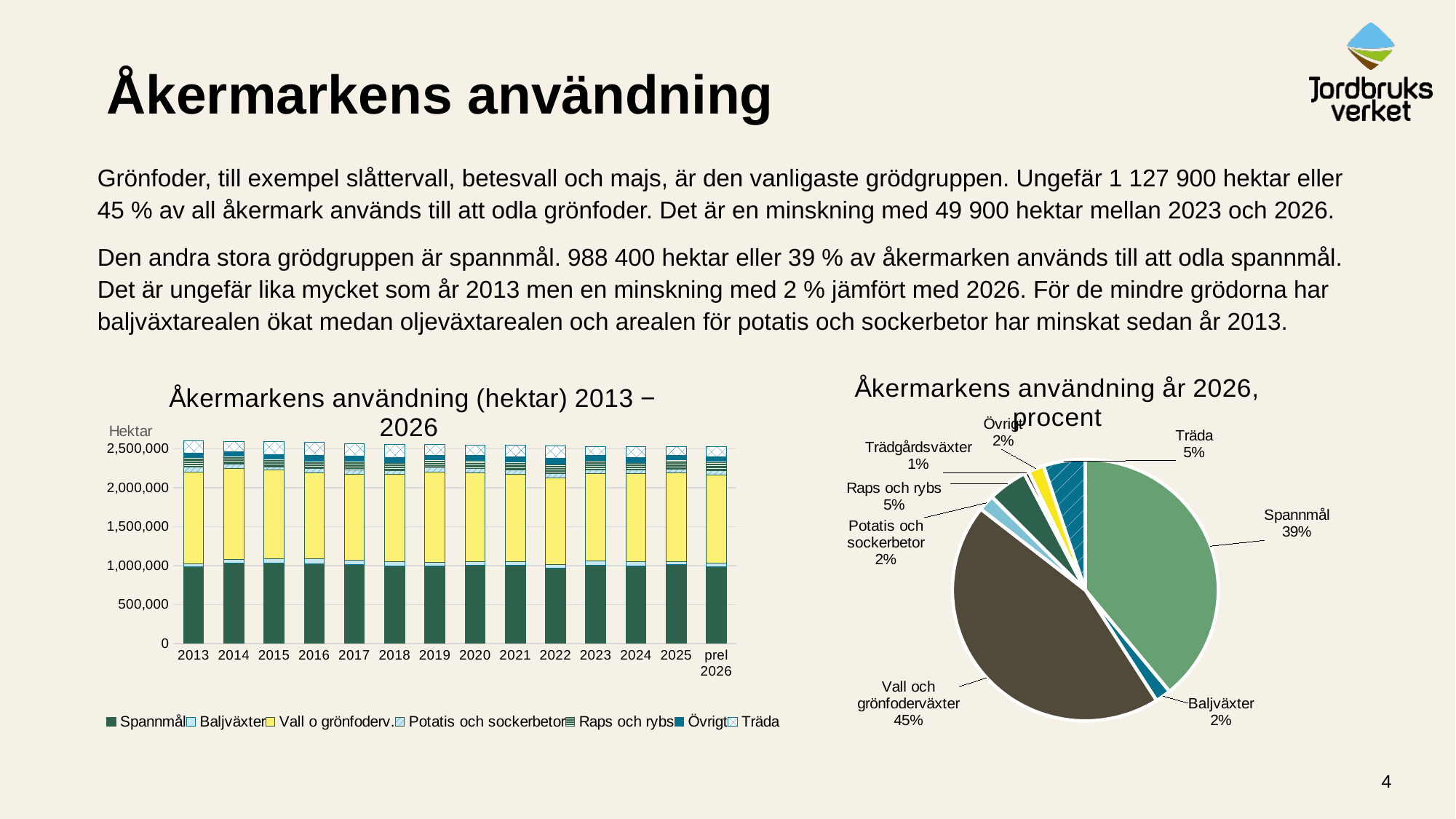
How many years (categories) are shown on the x axis of the bar chart 'Åkermarkens användning (hektar) 2013 – 2026'? 14 What kind of chart is 'Åkermarkens användning (hektar) 2013 – 2026'? Stacked bar chart How many slices does the pie chart 'Åkermarkens användning år 2026, procent' have? 8 In the pie chart 'Åkermarkens användning år 2026, procent', what is the difference in percentage points between Vall och grönfodervväxter and Spannmål? 6 percentage points In the pie chart 'Åkermarkens användning år 2026, procent', which is larger, Träda or Baljväxter? Träda In the pie chart 'Åkermarkens användning år 2026, procent', which category has the smallest share? Trädgårdsväxter In the pie chart 'Åkermarkens användning år 2026, procent', what share does Raps och rybs have? 5% In the pie chart 'Åkermarkens användning år 2026, procent', what share does Spannmål have? 39% In the bar chart 'Åkermarkens användning (hektar) 2013 – 2026', is the total height of the 2013 bar greater or less than 2,500,000? greater In the pie chart 'Åkermarkens användning år 2026, procent', what share does Vall och grönfodervväxter have? 45% In the pie chart 'Åkermarkens användning år 2026, procent', which category has the largest share? Vall och grönfoderväxter How many series does the legend of the bar chart 'Åkermarkens användning (hektar) 2013 – 2026' list? 7